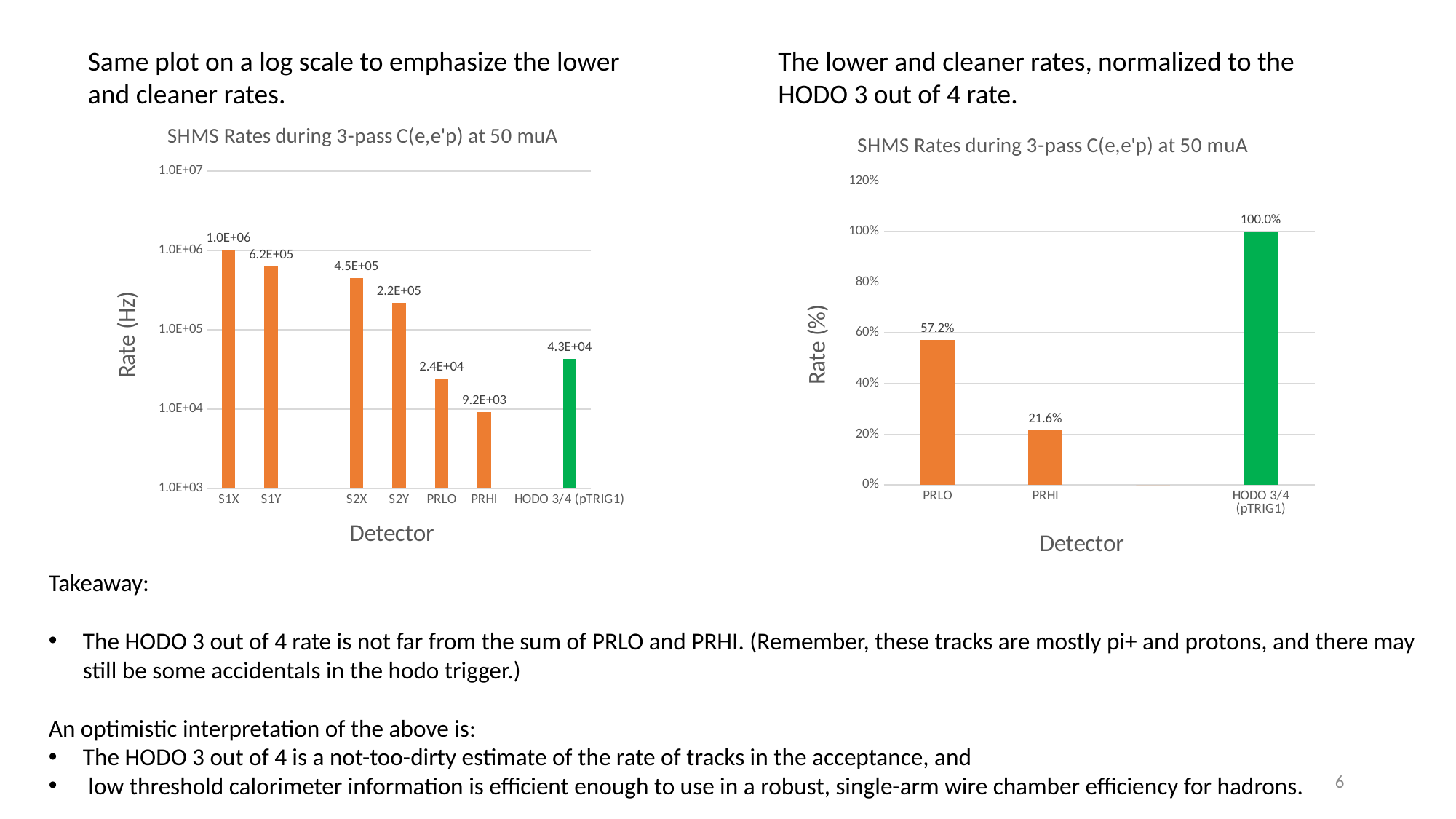
How many detector categories are plotted in the left chart? 7 In the left chart, which has the larger rate, S2Y or PRLO? S2Y In the left chart, what is the rate for HODO 3/4 (pTRIG1)? 4.3E+04 In the right chart, what is the difference between the HODO 3/4 (pTRIG1) value and the PRLO value? 42.8% In the left chart, what is the rate for S1X? 1.0E+06 In the right chart, what is the value for PRHI? 21.6% In the right chart, what is the value for PRLO? 57.2% How many detector categories are plotted in the right chart? 3 In the left chart, which detector has the highest rate? S1X What type of chart is the right chart? Bar chart In the left chart, what is the rate for PRHI? 9.2E+03 In the left chart, which detector has the lowest rate? PRHI